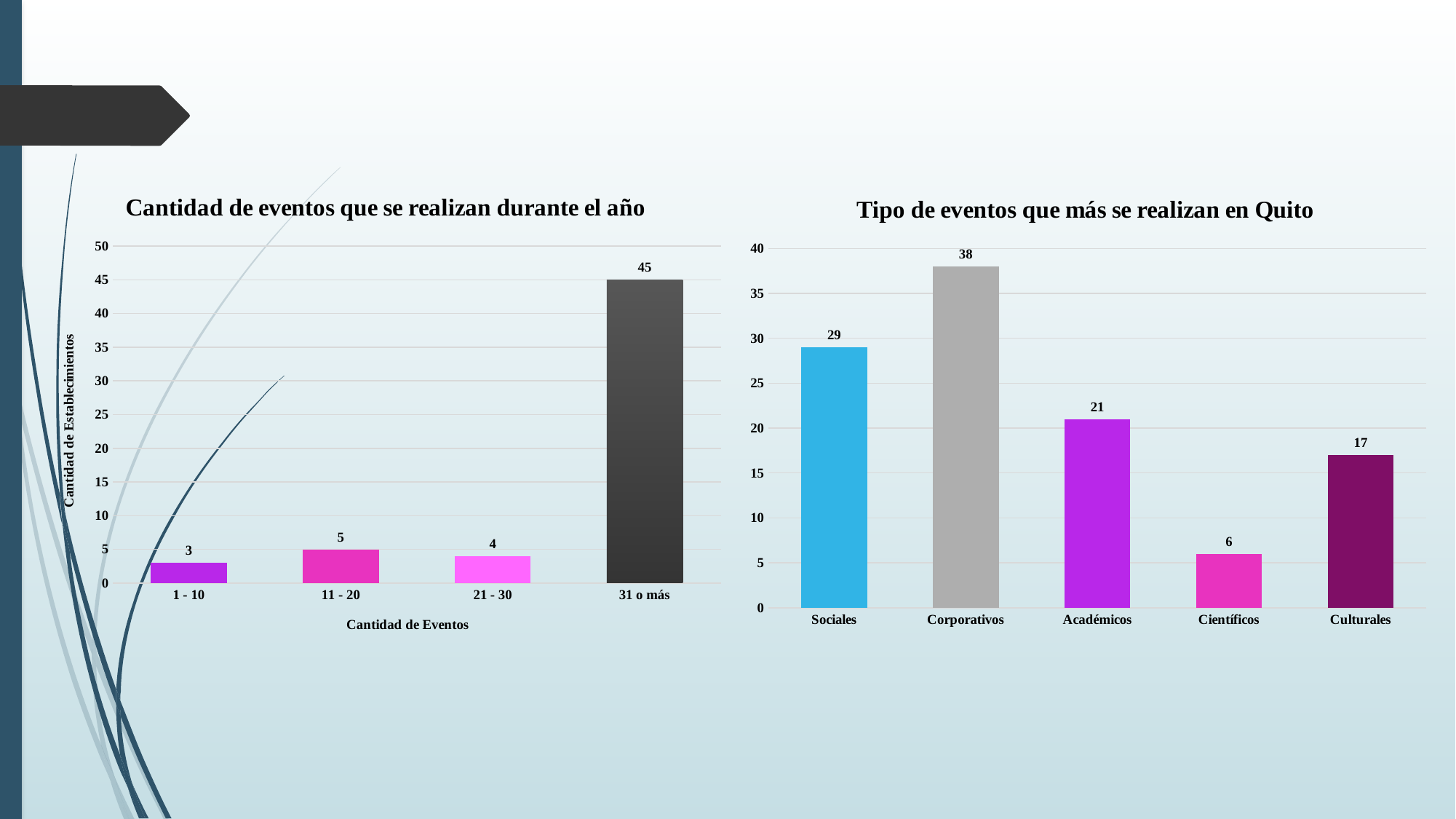
In the chart 'Tipo de eventos que más se realizan en Quito', which is larger, the value for 'Culturales' or the value for 'Académicos'? Académicos In the chart 'Cantidad de eventos que se realizan durante el año', what is the value for '11 - 20'? 5 In the chart 'Cantidad de eventos que se realizan durante el año', what is the label of the y axis? Cantidad de Establecimientos In the chart 'Cantidad de eventos que se realizan durante el año', how many categories are shown on the x axis? 4 In the chart 'Tipo de eventos que más se realizan en Quito', which category has the highest value? Corporativos In the chart 'Cantidad de eventos que se realizan durante el año', what is the difference between the values for '31 o más' and '21 - 30'? 41 In the chart 'Tipo de eventos que más se realizan en Quito', what is the difference between the values for 'Corporativos' and 'Sociales'? 9 In the chart 'Cantidad de eventos que se realizan durante el año', what is the value for '31 o más'? 45 In the chart 'Tipo de eventos que más se realizan en Quito', what is the value for 'Académicos'? 21 In the chart 'Tipo de eventos que más se realizan en Quito', which category has the lowest value? Científicos What kind of chart is 'Tipo de eventos que más se realizan en Quito'? Bar chart In the chart 'Cantidad de eventos que se realizan durante el año', which category has the lowest value? 1 - 10